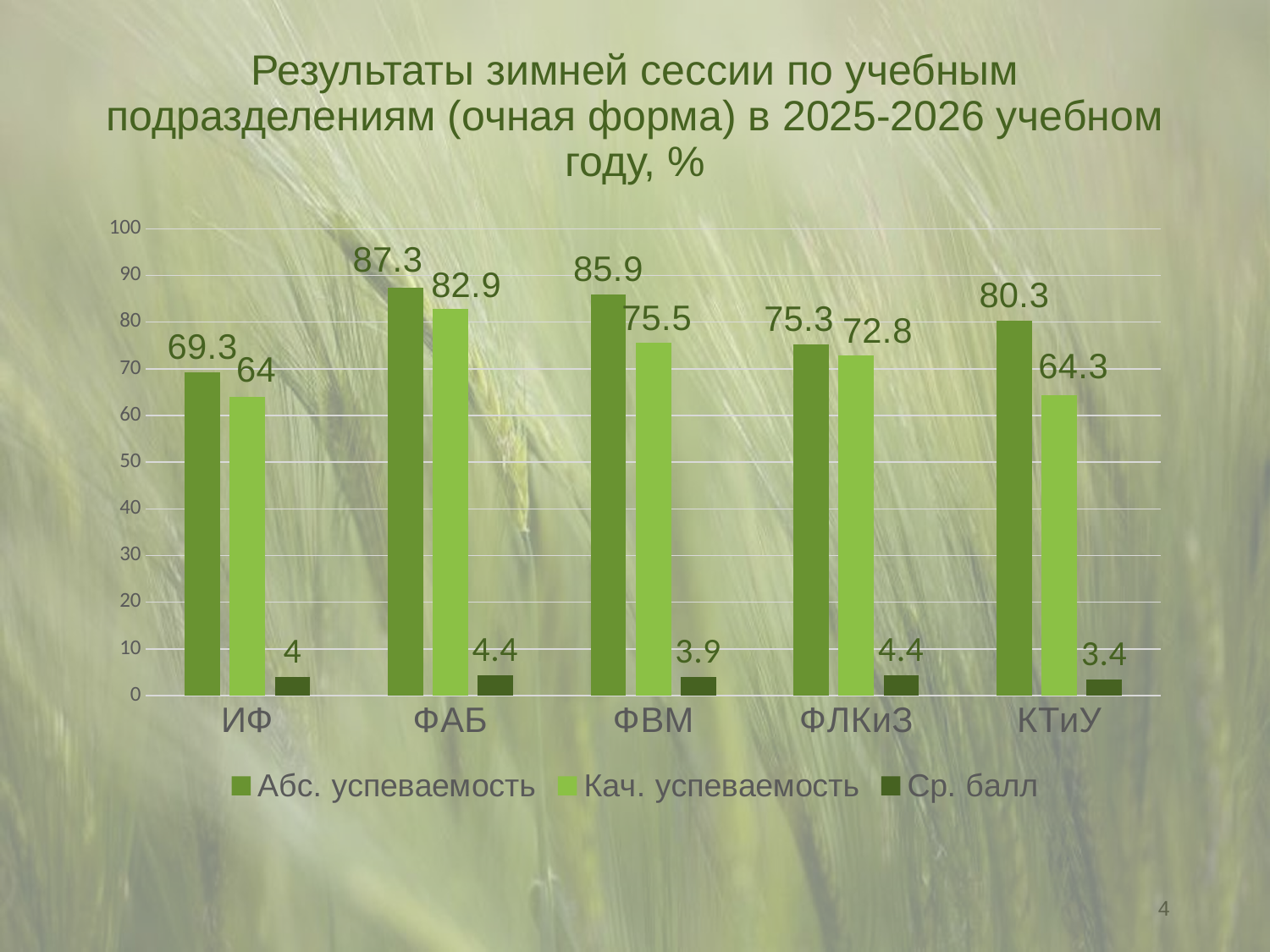
How many series does the legend list? 3 Which is larger: Кач. успеваемость for ФАБ or Кач. успеваемость for ФЛКиЗ? ФАБ What is the name of the third series in the legend? Ср. балл How many categories are shown on the x axis? 5 Which category has the lowest Кач. успеваемость? ИФ What is the value of Абс. успеваемость for ФАБ? 87.3 What kind of chart is shown on the slide? bar chart Which category has the lowest Ср. балл? КТиУ What is the value of Ср. балл for ФВМ? 3.9 What is the value of Кач. успеваемость for КТиУ? 64.3 Which category has the highest Абс. успеваемость? ФАБ What is the difference between Абс. успеваемость and Кач. успеваемость for ФВМ? 10.4